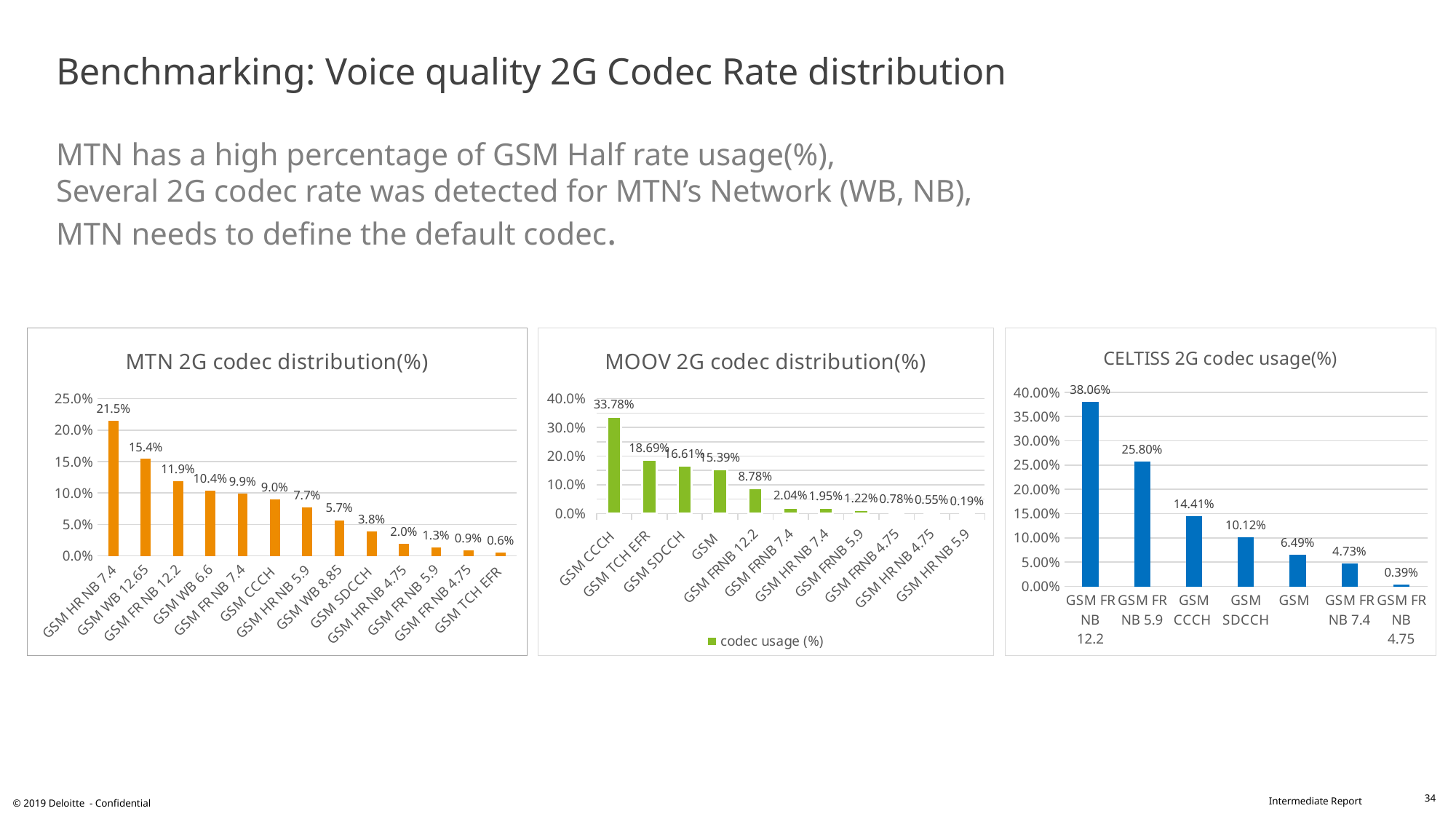
In the MTN 2G codec distribution(%) chart, which category has the lowest value? GSM TCH EFR In the MOOV 2G codec distribution(%) chart, what is the value for GSM SDCCH? 16.61% What series name does the legend of the MOOV 2G codec distribution(%) chart show? codec usage (%) How many categories are shown in the CELTISS 2G codec usage(%) chart? 7 In the MOOV 2G codec distribution(%) chart, which category has the highest value? GSM CCCH In the MOOV 2G codec distribution(%) chart, which is larger: GSM TCH EFR or GSM FRNB 12.2? GSM TCH EFR How many categories are shown in the MTN 2G codec distribution(%) chart? 13 In the MTN 2G codec distribution(%) chart, what is the difference between GSM WB 12.65 and GSM FR NB 12.2? 3.5% What type of chart is the CELTISS 2G codec usage(%) chart? Bar chart In the CELTISS 2G codec usage(%) chart, what is the difference between GSM FR NB 12.2 and GSM CCCH? 23.65% In the MTN 2G codec distribution(%) chart, what is the value for GSM HR NB 7.4? 21.5% In the CELTISS 2G codec usage(%) chart, what is the value for GSM FR NB 5.9? 25.80%